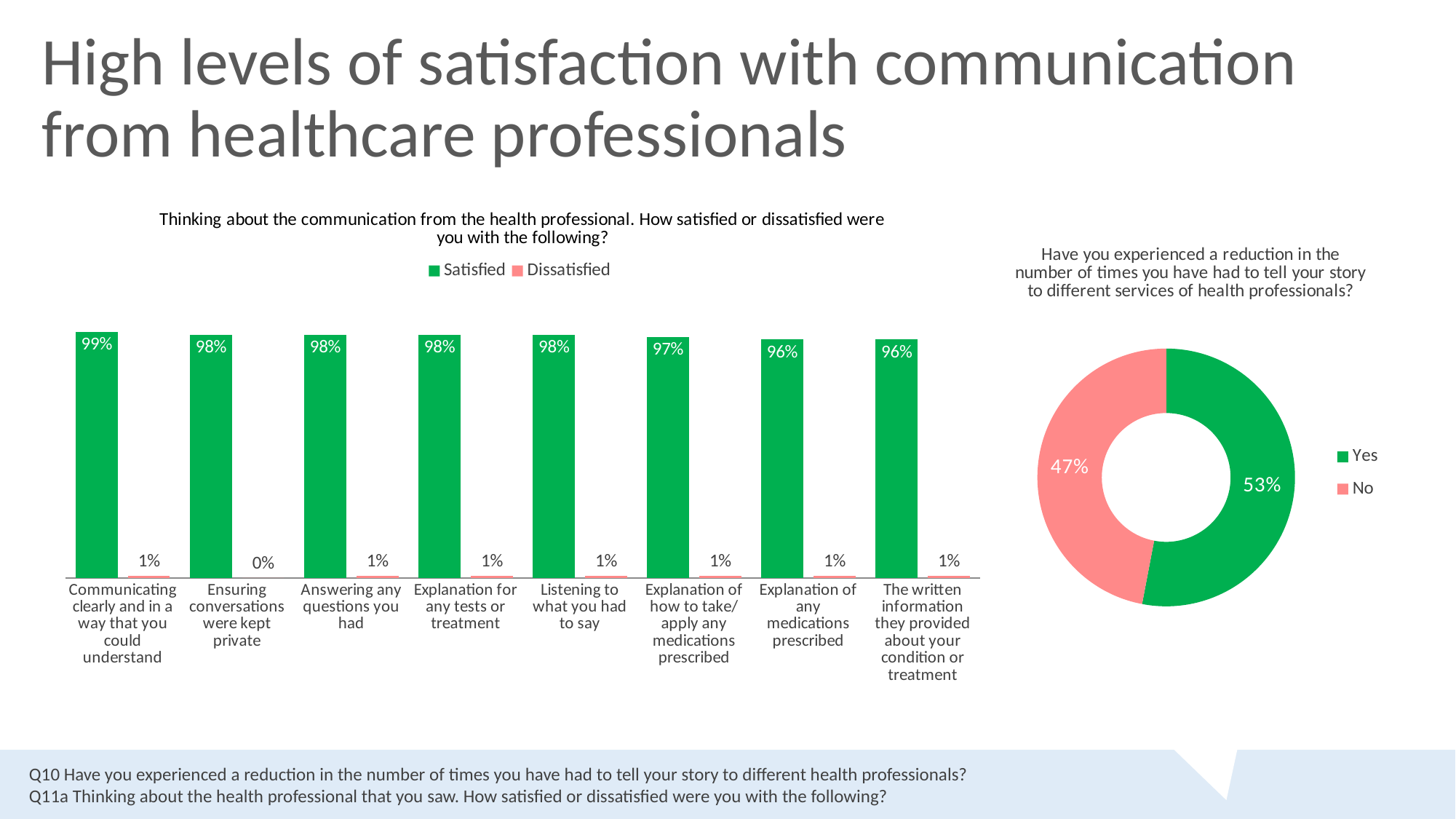
In the bar chart on the left, which category has the highest Satisfied value? Communicating clearly and in a way that you could understand What kind of chart is the chart on the right of the slide? Doughnut chart In the bar chart on the left, which colour represents the Dissatisfied series? Pink How many categories are shown in the bar chart on the left? 8 In the bar chart on the left, what is the difference between the Satisfied values for 'Communicating clearly and in a way that you could understand' and 'The written information they provided about your condition or treatment'? 3% In the bar chart on the left, what is the Dissatisfied value for 'Ensuring conversations were kept private'? 0% In the doughnut chart on the right, what share of respondents answered 'Yes'? 53% How many series does the legend of the bar chart on the left list? 2 In the doughnut chart on the right, what is the difference between the 'Yes' and 'No' shares? 6% In the bar chart on the left, what is the Satisfied value for 'Explanation of how to take/apply any medications prescribed'? 97% In the bar chart on the left, which is larger: the Satisfied value for 'Listening to what you had to say' or for 'Explanation of any medications prescribed'? Listening to what you had to say In the bar chart on the left, what is the Satisfied value for 'Communicating clearly and in a way that you could understand'? 99%